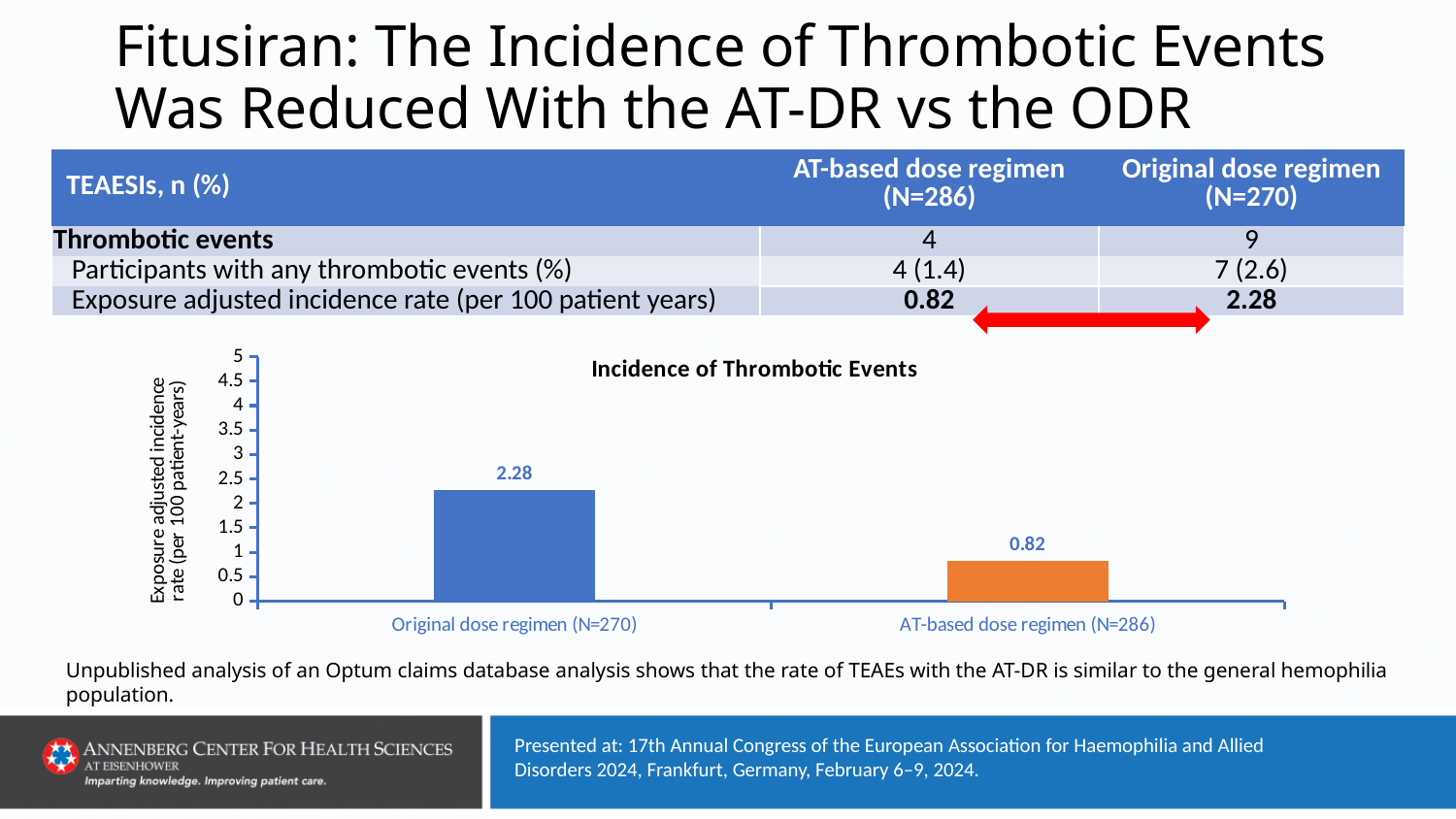
Is the incidence rate for the Original dose regimen greater or less than 2? greater Is the incidence rate for the AT-based dose regimen greater or less than 1? less What is the exposure adjusted incidence rate for the Original dose regimen (N=270) in the chart? 2.28 What is the label of the y-axis of the chart? Exposure adjusted incidence rate (per 100 patient-years) What is the maximum value shown on the y-axis of the chart? 5 Which dose regimen has the higher incidence of thrombotic events in the chart? Original dose regimen (N=270) How many categories are shown in the chart? 2 What is the title of the chart? Incidence of Thrombotic Events What is the difference between the incidence rates of the Original dose regimen and the AT-based dose regimen? 1.46 What is the exposure adjusted incidence rate for the AT-based dose regimen (N=286) in the chart? 0.82 What type of chart is shown on the slide? Bar chart Which dose regimen has the lower incidence of thrombotic events in the chart? AT-based dose regimen (N=286)